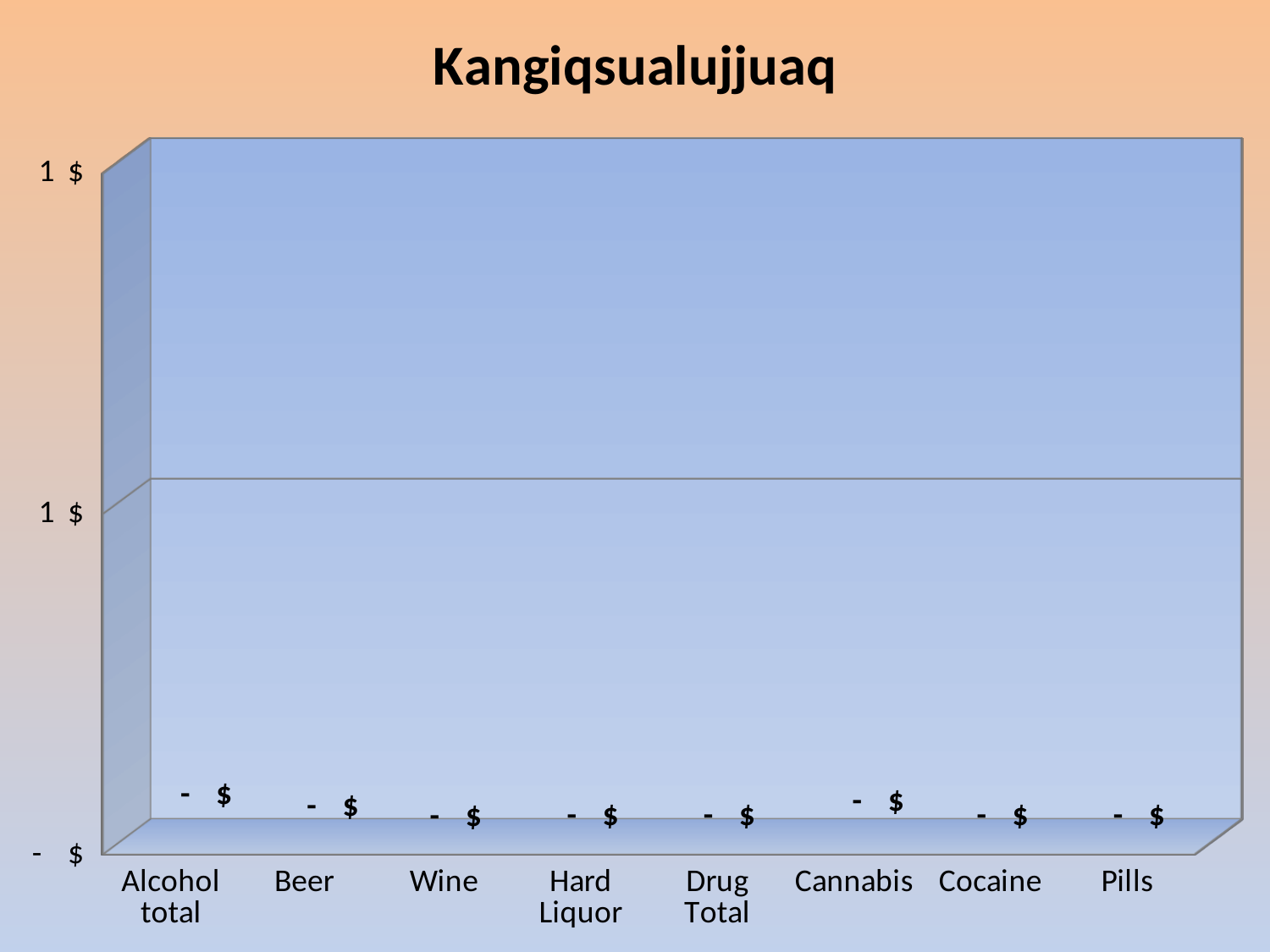
Do the values rise, fall, or stay flat across the categories on the x axis? stay flat What is the first category listed on the x axis? Alcohol total What kind of chart is shown on the slide? bar chart What data label is shown for Pills? - $ How many categories are shown on the x axis of the chart? 8 What data label is shown for Drug Total? - $ What is the title of the chart? Kangiqsualujjuaq What data label is shown for Alcohol total? - $ What data label is shown for Cannabis? - $ What data label is shown for Beer? - $